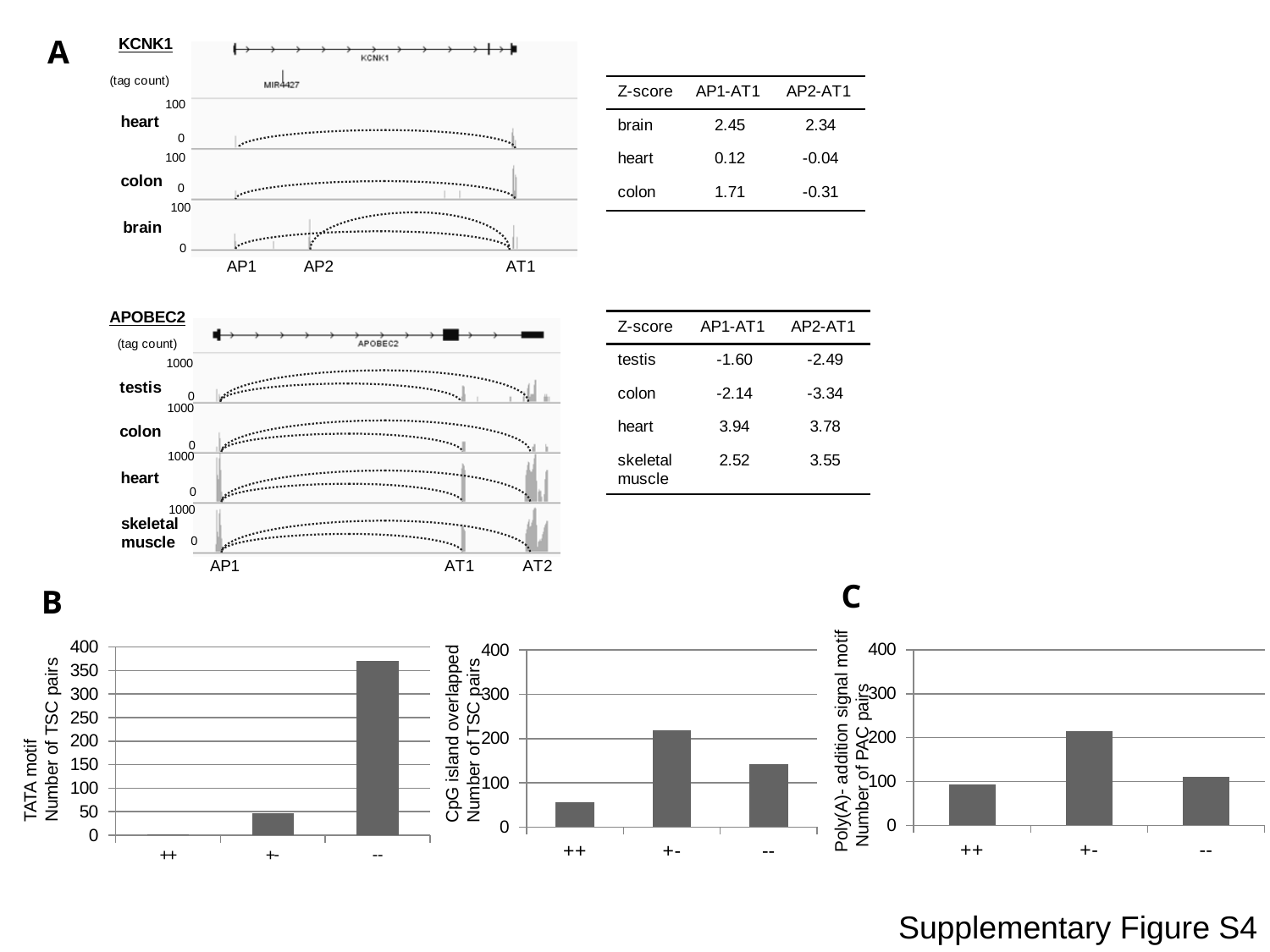
How many categories are shown on the x axis of the TATA motif chart (panel B, left)? 3 In the CpG island overlapped chart (panel B, middle), which is larger, the value for -- or the value for ++? -- In the TATA motif chart (panel B, left), is the value for +- greater or less than 100? less In the CpG island overlapped chart (panel B, middle), which category has the highest number of TSC pairs? +- In the Poly(A)-addition signal motif chart (panel C), which is larger, the value for +- or the value for --? +- What kind of chart is used in panel C? bar chart In the Poly(A)-addition signal motif chart (panel C), which category has the highest number of PAC pairs? +- In the CpG island overlapped chart (panel B, middle), which category has the lowest number of TSC pairs? ++ In the TATA motif chart (panel B, left), is the value for -- greater or less than 300? greater In the TATA motif chart (panel B, left), which category has the highest number of TSC pairs? -- In the CpG island overlapped chart (panel B, middle), is the value for +- greater or less than 200? greater